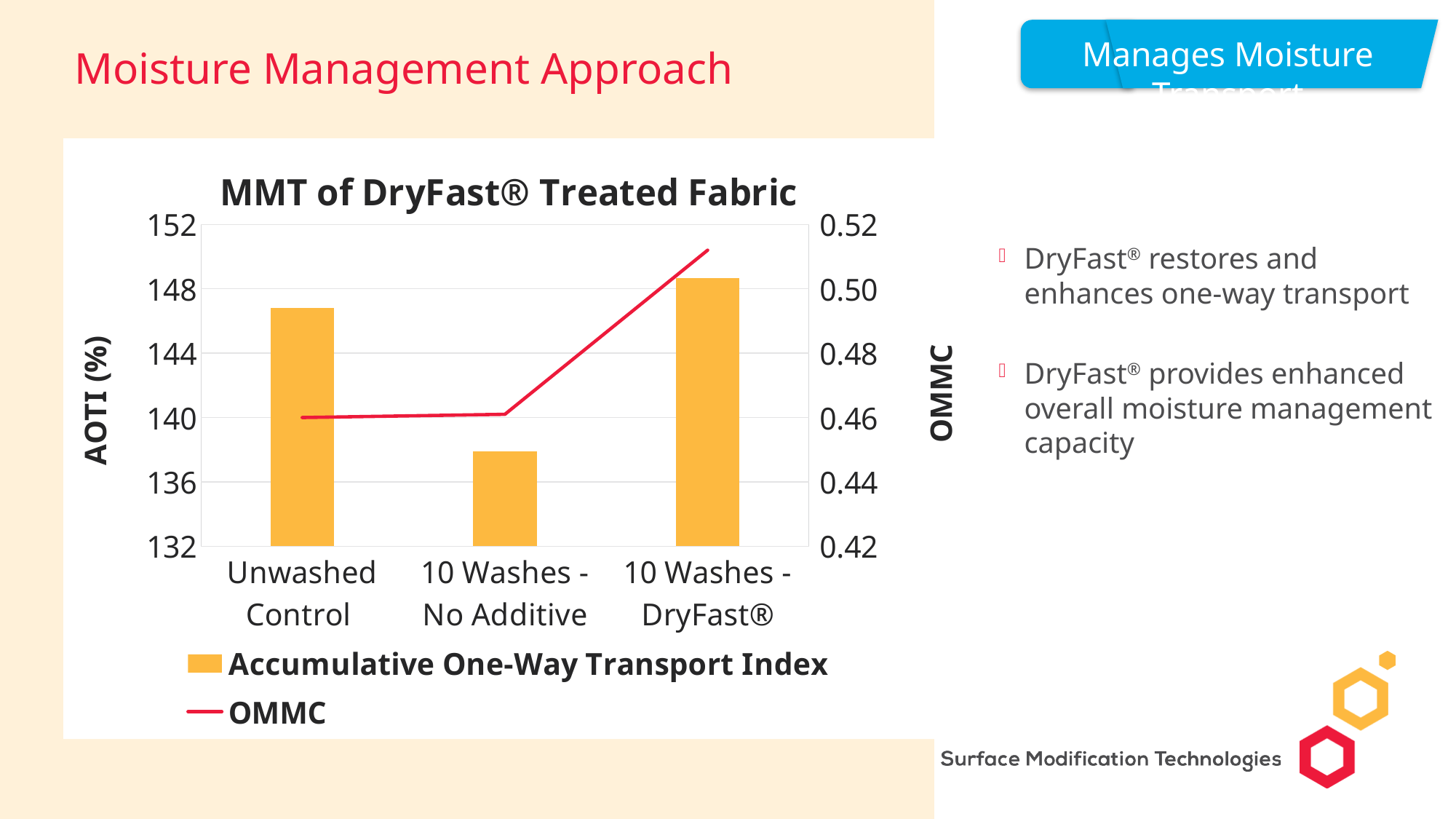
How many series does the chart legend list? 2 Is the Accumulative One-Way Transport Index for 10 Washes - No Additive greater or less than 140? less Which has a larger Accumulative One-Way Transport Index, Unwashed Control or 10 Washes - No Additive? Unwashed Control Is the OMMC value for 10 Washes - DryFast® greater or less than 0.50? greater Which category has the highest Accumulative One-Way Transport Index bar? 10 Washes - DryFast® Which category has the lowest Accumulative One-Way Transport Index bar? 10 Washes - No Additive Which category has the highest OMMC value? 10 Washes - DryFast® Is the Accumulative One-Way Transport Index for Unwashed Control greater or less than 144? greater How many categories are shown on the x axis of the chart? 3 What type of chart is shown on the slide? A combined bar and line chart What is the label of the left vertical axis? AOTI (%) What is the title of the chart? MMT of DryFast® Treated Fabric